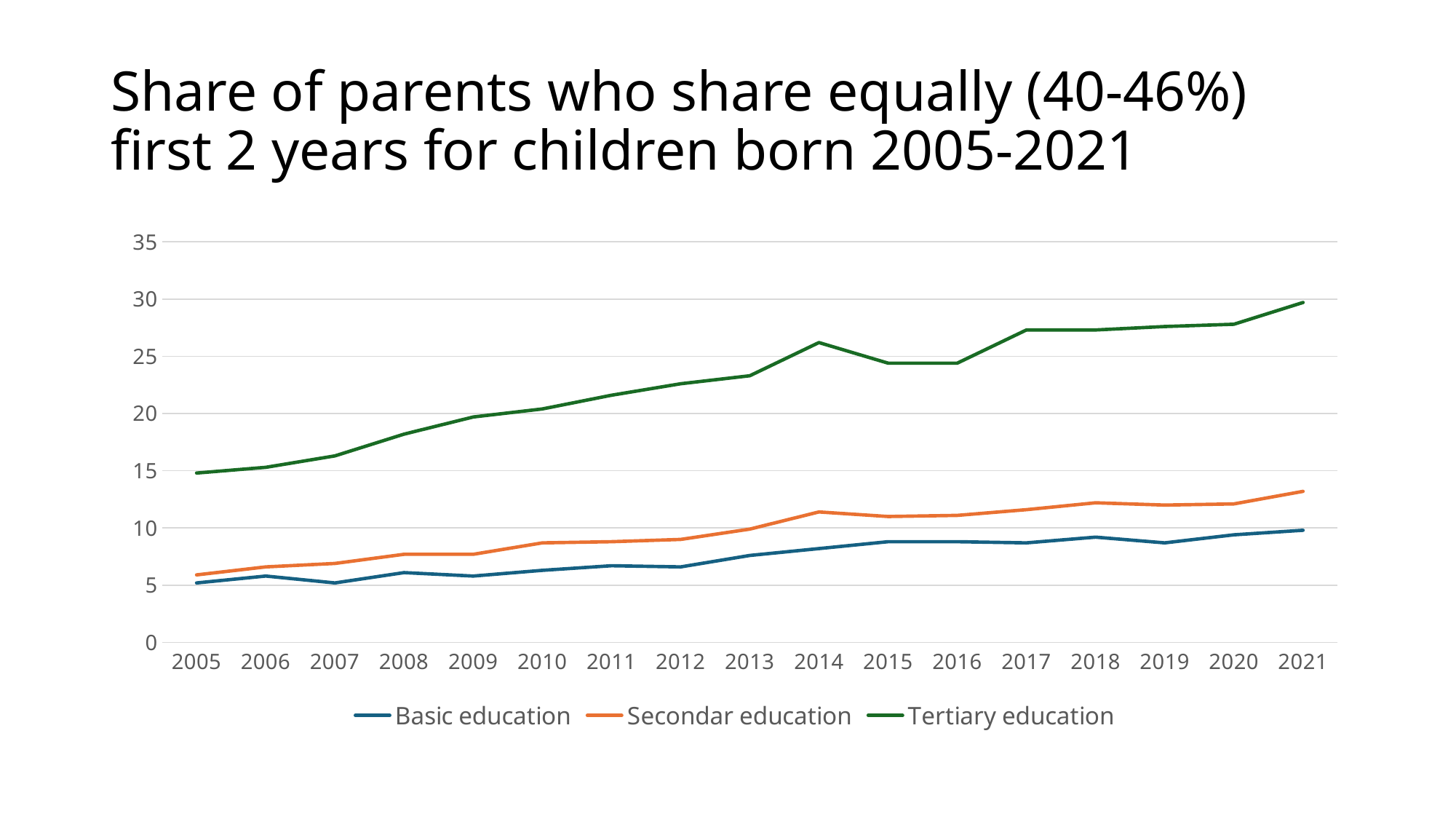
For Tertiary education, which year has the larger value, 2014 or 2015? 2014 What colour is the Tertiary education line? green Is the value for Basic education in 2005 greater or less than 10? less Is the value for Tertiary education in 2021 greater or less than 25? greater Which series has the lowest value in 2005? Basic education What kind of chart is shown on the slide? line chart How many series does the legend list? 3 Is the value for Tertiary education in 2005 greater or less than 20? less Which series has the highest value in 2021? Tertiary education Does the Tertiary education line rise or fall overall from 2005 to 2021? rise How many years are shown along the x axis? 17